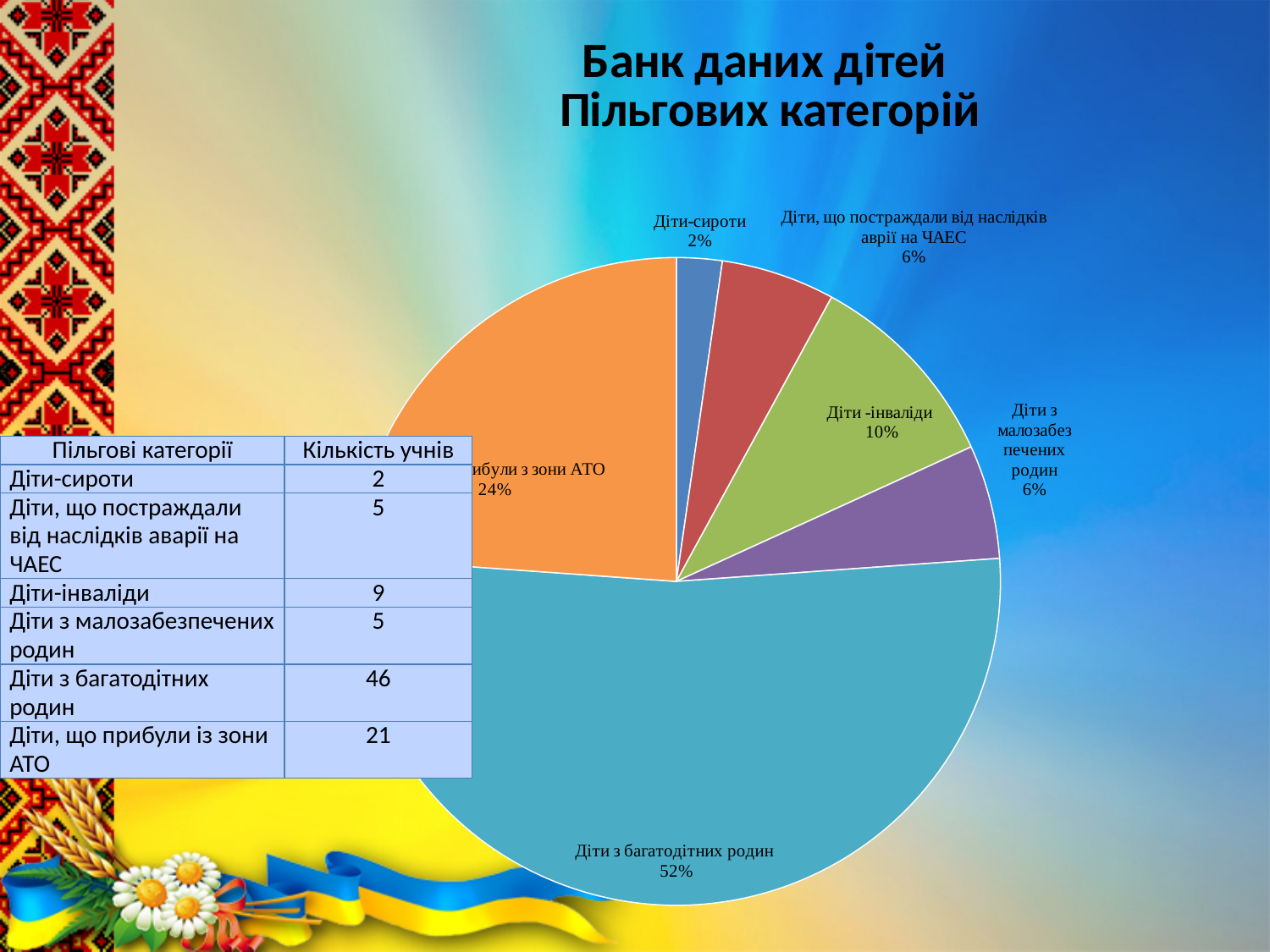
What percentage is shown for Діти, що постраждали від наслідків аварії на ЧАЕС in the pie chart? 6% Which slice is larger: Діти-інваліди or Діти-сироти? Діти-інваліди What percentage is shown for Діти-інваліди in the pie chart? 10% What percentage is shown for Діти-сироти in the pie chart? 2% How many slices does the pie chart have? 6 What share of the pie does Діти з багатодітних родин represent? 52% What kind of chart is shown on the slide? pie chart What is the title of the slide with the pie chart? Банк даних дітей Пільгових категорій Is the share for Діти з багатодітних родин greater or less than 50%? greater Which category has the smallest slice in the pie chart? Діти-сироти Which category has the largest slice in the pie chart? Діти з багатодітних родин What is the difference in percentage points between the slice for Діти з багатодітних родин and the slice labelled 24% (children from the ATO zone)? 28%